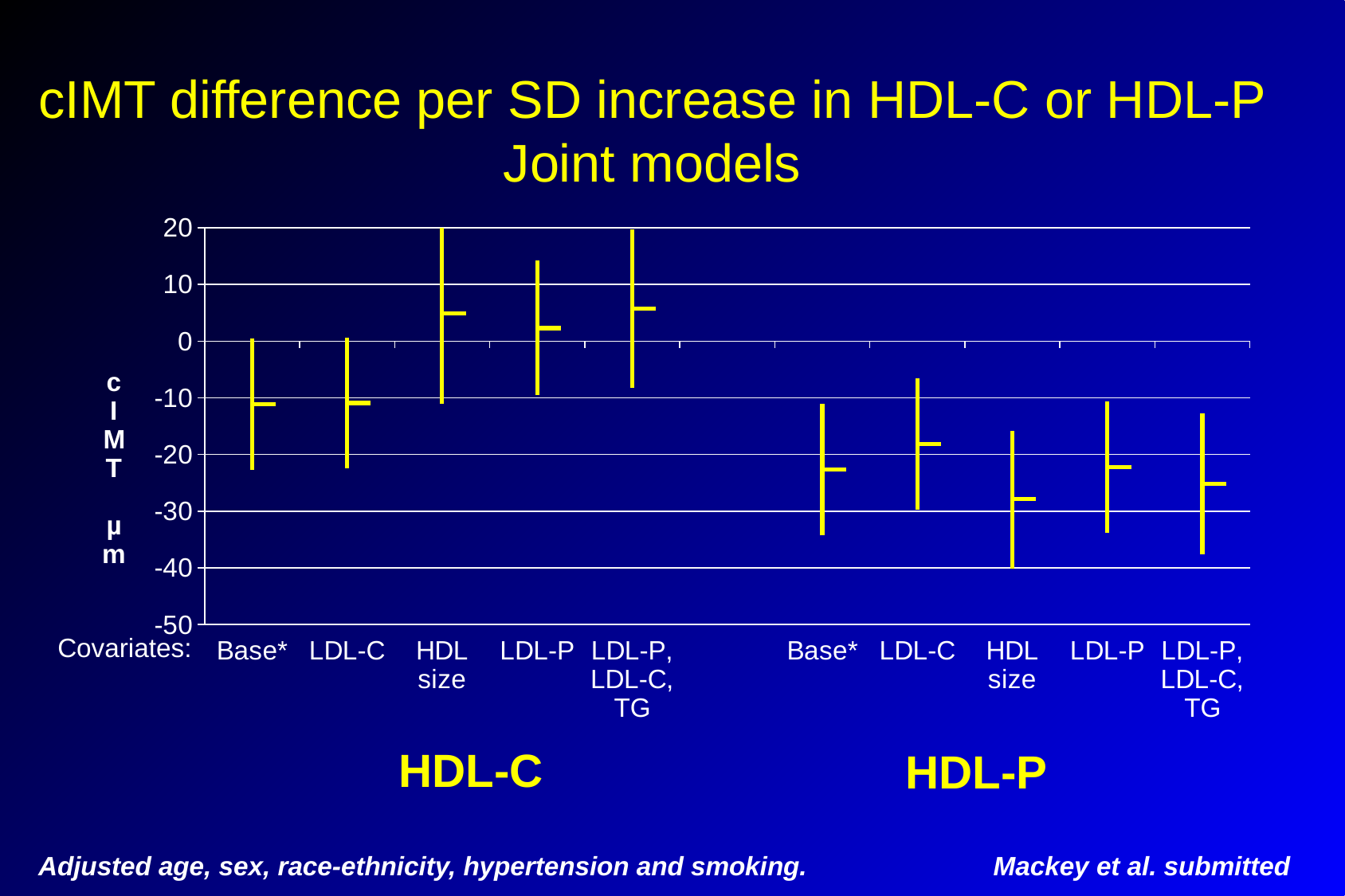
How many covariate models are plotted for the HDL-C group? 5 Is the point estimate for HDL size in the HDL-P group greater or less than -20? less How many point estimates with error bars are plotted in total across both the HDL-C and HDL-P groups? 10 Is the point estimate for LDL-P, LDL-C, TG in the HDL-C group greater or less than 0? greater Which has the larger point estimate: HDL size in the HDL-C group or HDL size in the HDL-P group? HDL size in the HDL-C group Within the HDL-P group, which has the larger point estimate: LDL-C or HDL size? LDL-C What unit is shown on the y-axis label of the chart? µm Is the point estimate for HDL size in the HDL-C group greater or less than 0? greater What is the lowest value shown on the y-axis of the chart? -50 What is the title of the chart on the slide? cIMT difference per SD increase in HDL-C or HDL-P Joint models